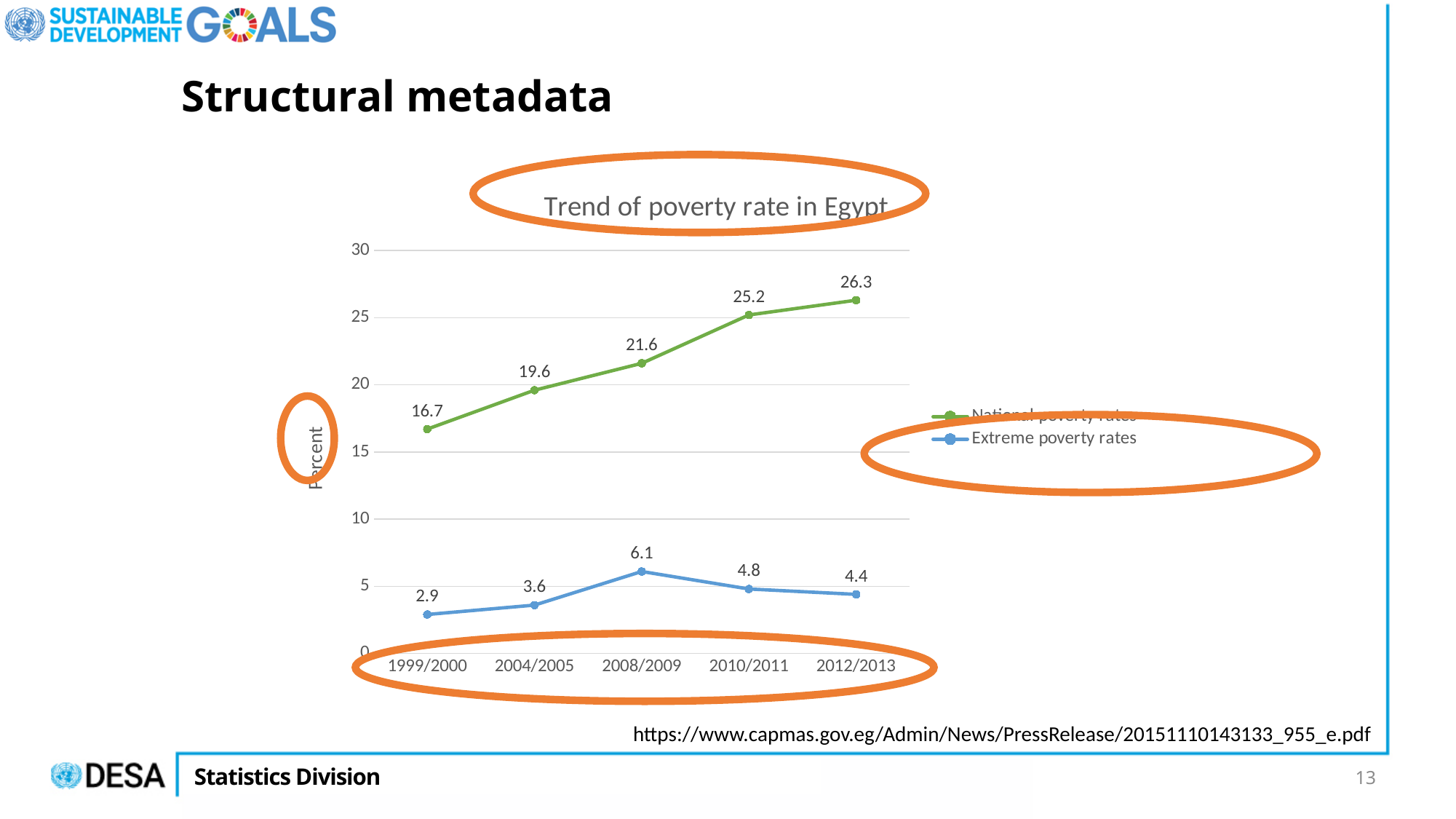
What kind of chart is shown on the slide? line chart What is the National poverty rate for 1999/2000? 16.7 In which period is the National poverty rate lowest? 1999/2000 Is the National poverty rate for 2008/2009 greater or less than 20? greater What is the difference between the National poverty rate and the Extreme poverty rate in 2010/2011? 20.4 Does the National poverty rate rise or fall from 1999/2000 to 2012/2013? rise What is the National poverty rate for 2012/2013? 26.3 How many time periods are shown on the x axis? 5 How many series does the legend list? 2 What is the Extreme poverty rate for 2008/2009? 6.1 In which period is the Extreme poverty rate highest? 2008/2009 Which is larger: the Extreme poverty rate in 2004/2005 or in 2012/2013? 2012/2013